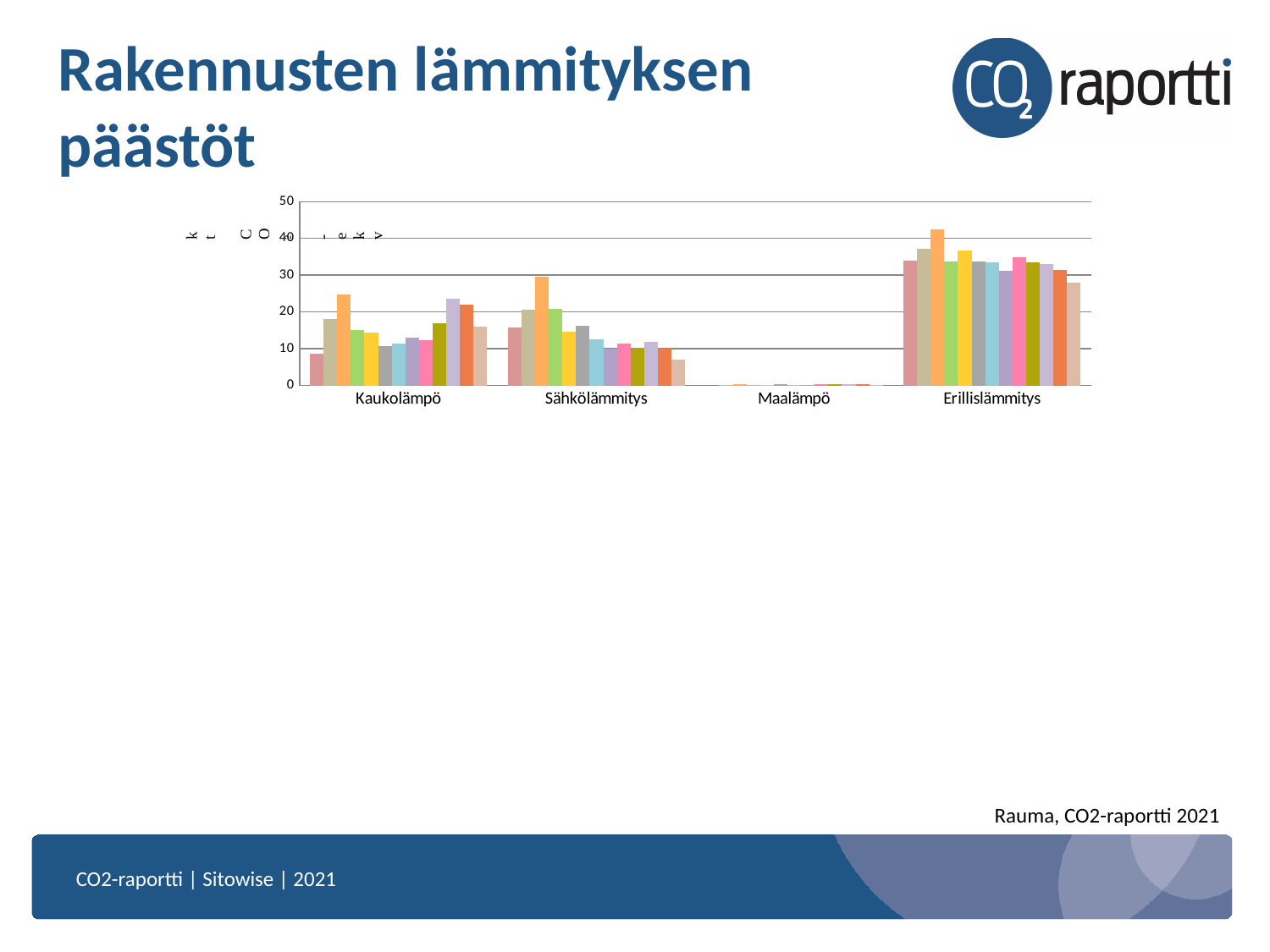
Which heating category has the highest emissions in the chart? Erillislämmitys Which heating category has the lowest emissions in the chart? Maalämpö What kind of chart is shown on the slide? bar chart Is the tallest bar for Sähkölämmitys greater or less than 20? greater Are the values for Maalämpö greater or less than 10? less Which category has larger emissions, Kaukolämpö or Maalämpö? Kaukolämpö How many heating categories are shown on the x axis of the chart? 4 What is the title of the slide containing the chart? Rakennusten lämmityksen päästöt What is the maximum value shown on the chart's y axis? 50 Is the tallest bar for Erillislämmitys greater or less than 40? greater Which category has larger emissions, Erillislämmitys or Sähkölämmitys? Erillislämmitys